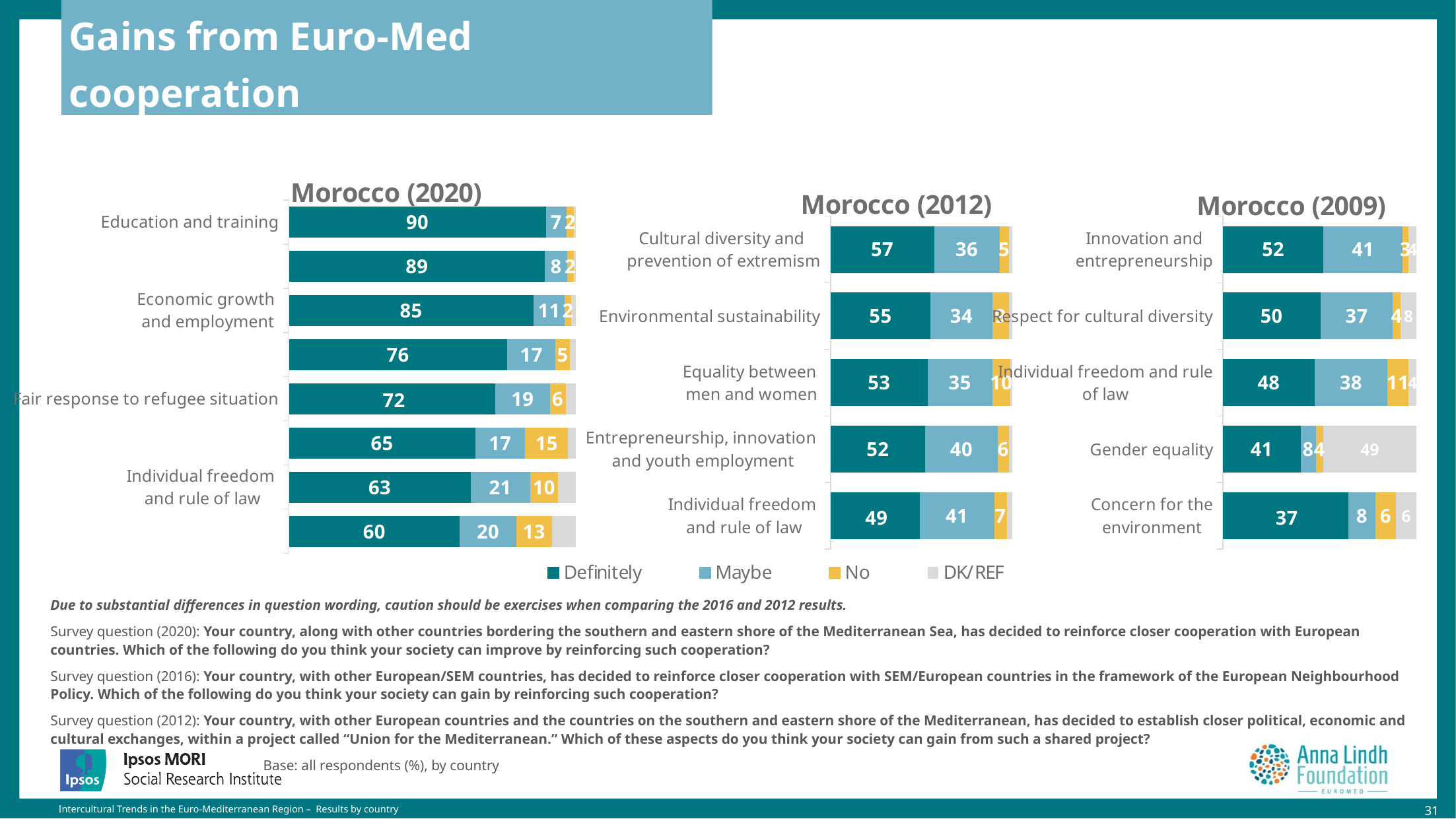
In the Morocco (2009) chart, what is the DK/REF value for Gender equality? 49 In the Morocco (2012) chart, which has the larger Maybe value: Individual freedom and rule of law or Equality between men and women? Individual freedom and rule of law In the Morocco (2012) chart, what is the Definitely value for Environmental sustainability? 55 In the Morocco (2012) chart, which category has the highest Definitely value? Cultural diversity and prevention of extremism In the Morocco (2009) chart, which category has the lowest Definitely value? Concern for the environment In the Morocco (2009) chart, what is the Definitely value for Concern for the environment? 37 What kind of chart is used for Morocco (2020)? Stacked bar chart In the Morocco (2020) chart, do the Definitely values rise or fall going from the top bar to the bottom bar? Fall In the Morocco (2020) chart, what is the difference between the Definitely values for Education and training and Individual freedom and rule of law? 27 In the Morocco (2020) chart, what is the Definitely value for Education and training? 90 How many series does the legend list? 4 How many categories are shown in the Morocco (2012) chart? 5